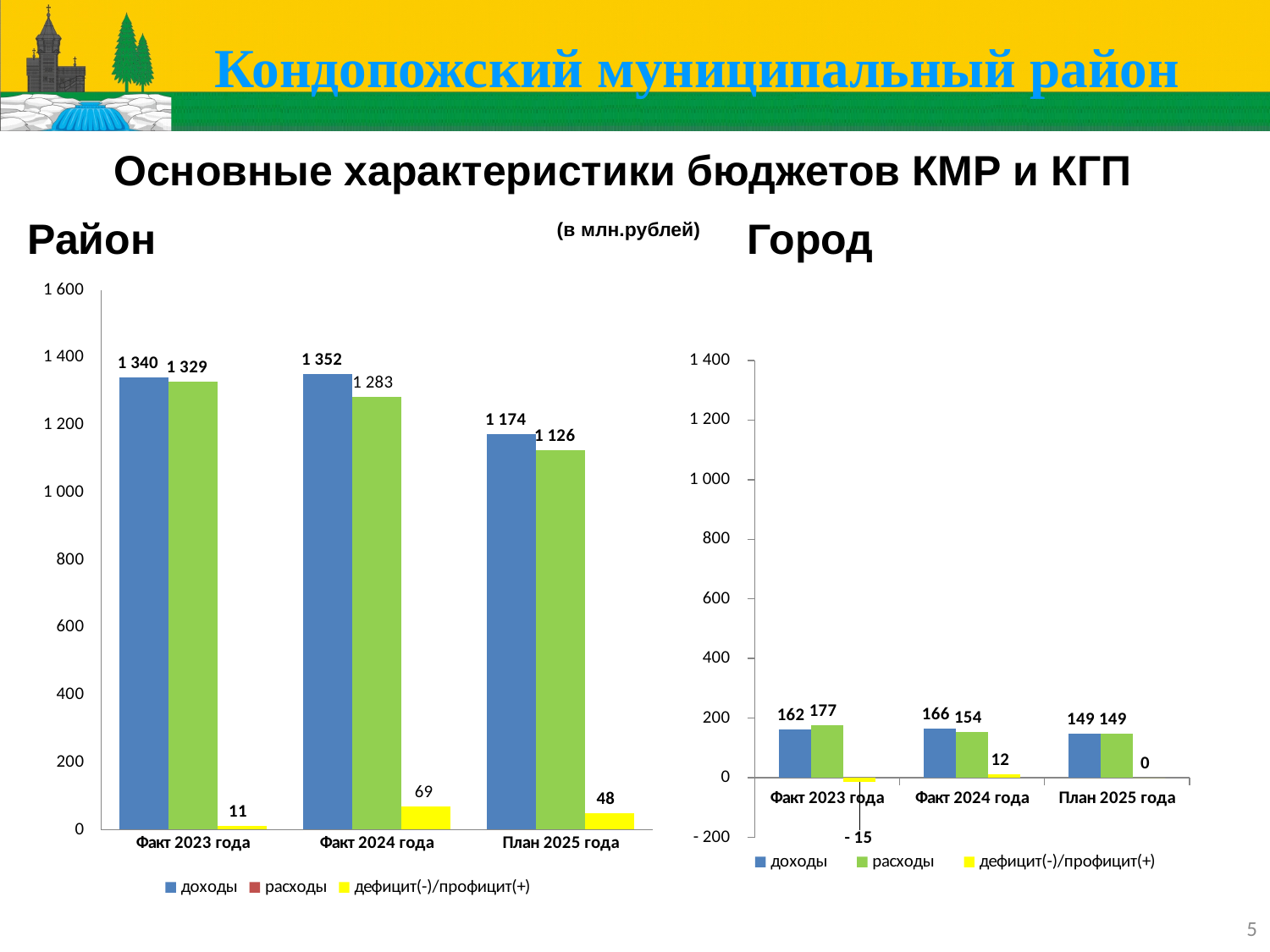
In the Район chart, what is the value of доходы for Факт 2024 года? 1 352 In the Район chart, what is the value of расходы for План 2025 года? 1 126 In the Город chart, which is larger for Факт 2023 года: доходы or расходы? расходы In the Район chart, which category has the highest дефицит(-)/профицит(+) value? Факт 2024 года How many categories are shown on the x axis of the Город chart? 3 In the Район chart, what is the difference between доходы and расходы for Факт 2024 года? 69 What type of chart is the Город chart? bar chart In the Район chart, is the value of расходы for План 2025 года greater or less than 1 200? less In the Город chart, which category has the lowest доходы value? План 2025 года In the Город chart, what is the value of дефицит(-)/профицит(+) for Факт 2023 года? - 15 In the Город chart, what is the value of расходы for Факт 2023 года? 177 How many series does the legend of the Район chart list? 3